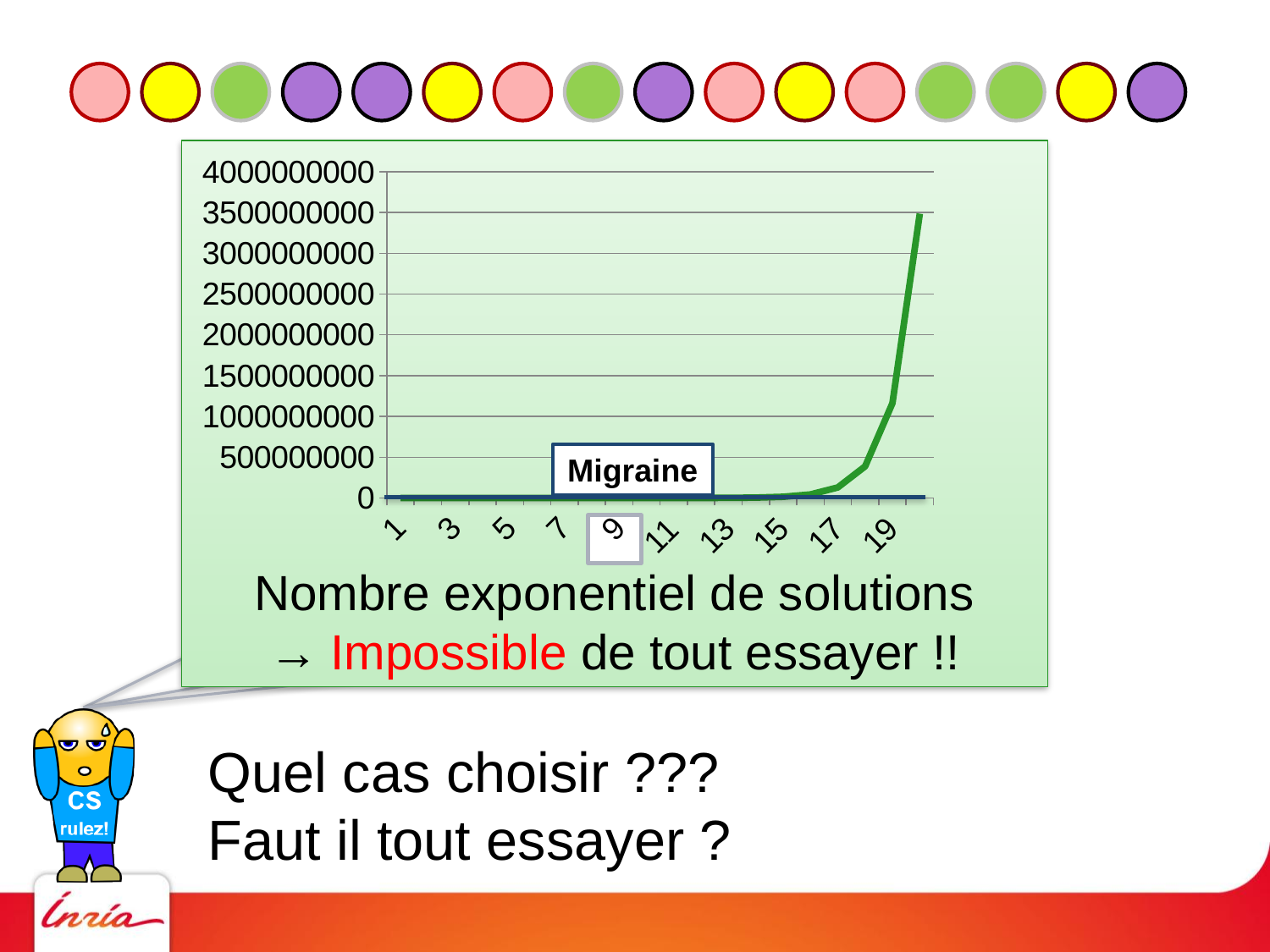
Is the value at the rightmost point of the line greater or less than 4000000000? less What is the highest value shown on the chart's y axis? 4000000000 How many labels are printed along the chart's x axis? 10 Which is larger, the value at x = 9 or the value at the rightmost point of the line? the rightmost point Is the value at the rightmost point of the line greater or less than 3000000000? greater Is the value at x = 1 greater or less than 500000000? less What word is written in the label box inside the chart area? Migraine Which point on the line has the highest value, the leftmost or the rightmost? the rightmost Do the values on the chart rise or fall as the x axis increases from 1 to 19? rise What kind of chart is shown on the slide? line chart